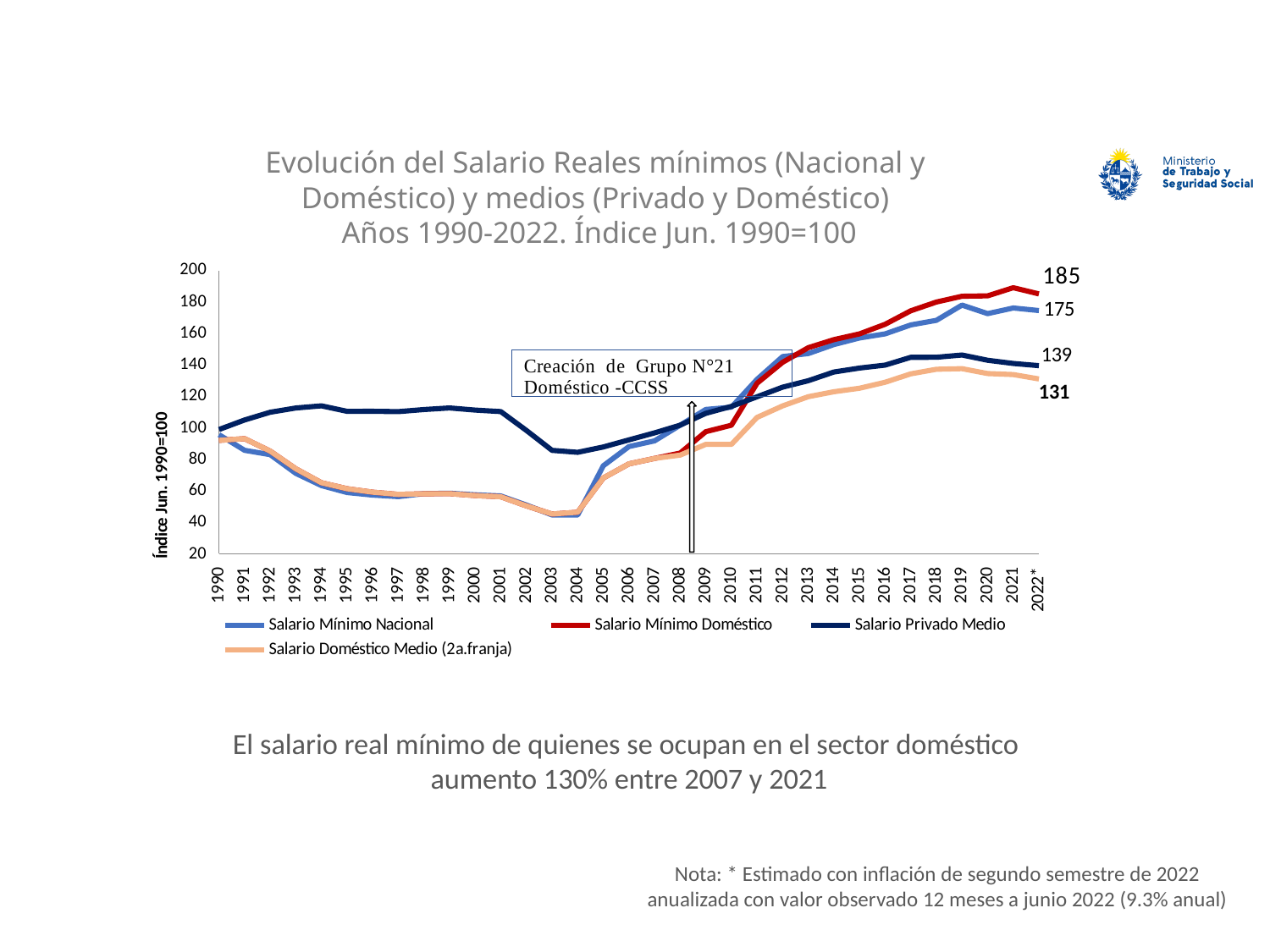
What is the value of Salario Mínimo Doméstico in 2022*? 185 Which series has the highest value in 2022*? Salario Mínimo Doméstico Is the value of Salario Mínimo Nacional in 2004 greater or less than 60? less Which series has the lowest value in 2022*? Salario Doméstico Medio (2a.franja) What event does the text box annotation on the chart refer to? Creación de Grupo N°21 Doméstico -CCSS What is the value of Salario Doméstico Medio (2a.franja) in 2022*? 131 How many series does the legend list? 4 What is the value of Salario Mínimo Nacional in 2022*? 175 What is the difference between the 2022* values of Salario Mínimo Doméstico and Salario Mínimo Nacional? 10 What kind of chart is shown on the slide? line chart Does the Salario Mínimo Doméstico series rise or fall between 2007 and 2021? rise What is the value of Salario Privado Medio in 2022*? 139